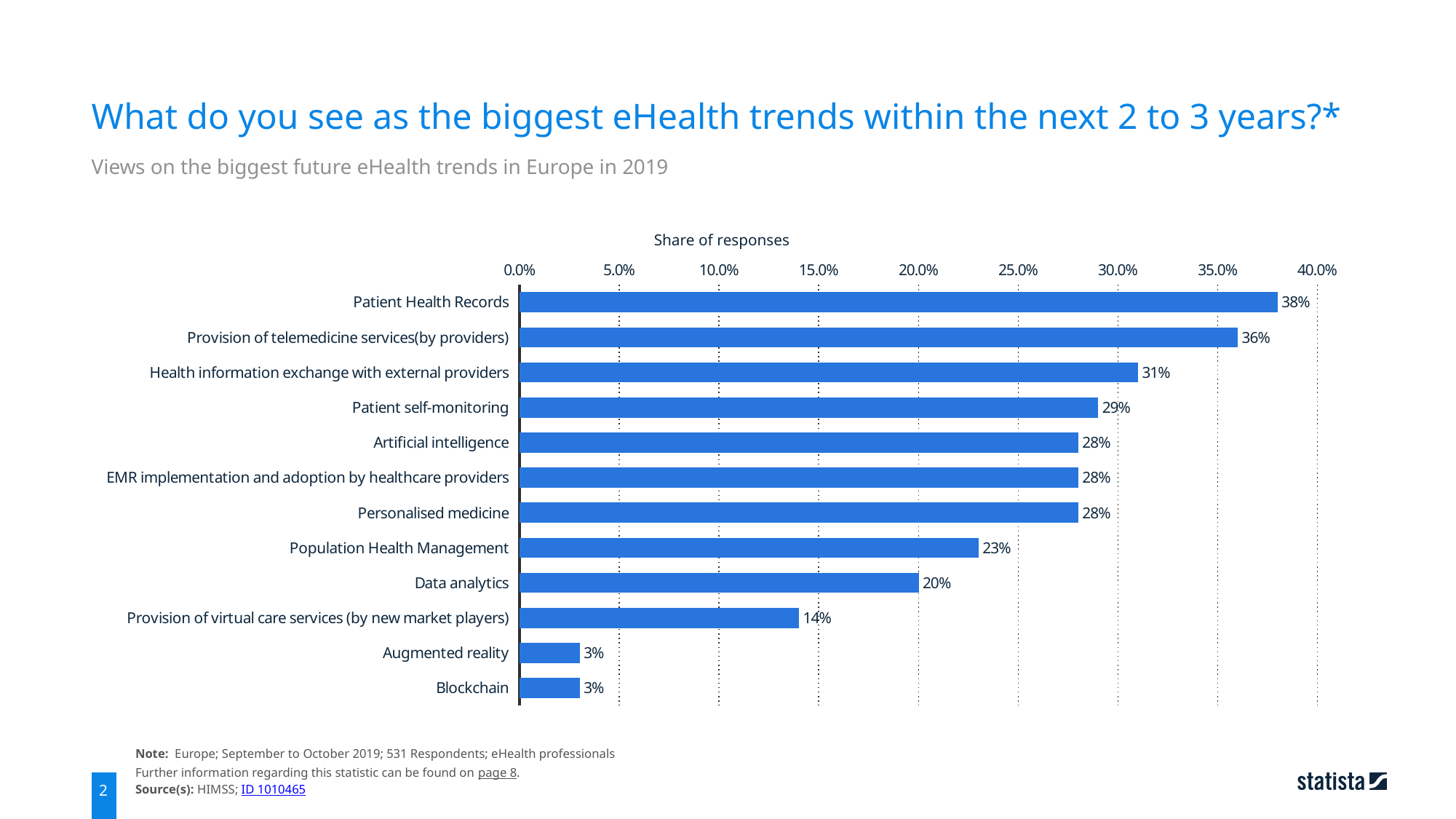
What is the share of responses for Data analytics? 20% Which category has the highest share of responses? Patient Health Records What is the subtitle of the chart? Views on the biggest future eHealth trends in Europe in 2019 What is the label of the horizontal axis? Share of responses Is the value for Population Health Management greater or less than 25.0%? less What is the difference in share of responses between Patient Health Records and Provision of telemedicine services(by providers)? 2% What kind of chart is shown on the slide? Bar chart How many categories are shown in the chart? 12 What is the share of responses for Provision of virtual care services (by new market players)? 14% What is the difference in share of responses between Health information exchange with external providers and Population Health Management? 8% What is the share of responses for Patient Health Records? 38% Which has a larger share of responses, Patient self-monitoring or Data analytics? Patient self-monitoring